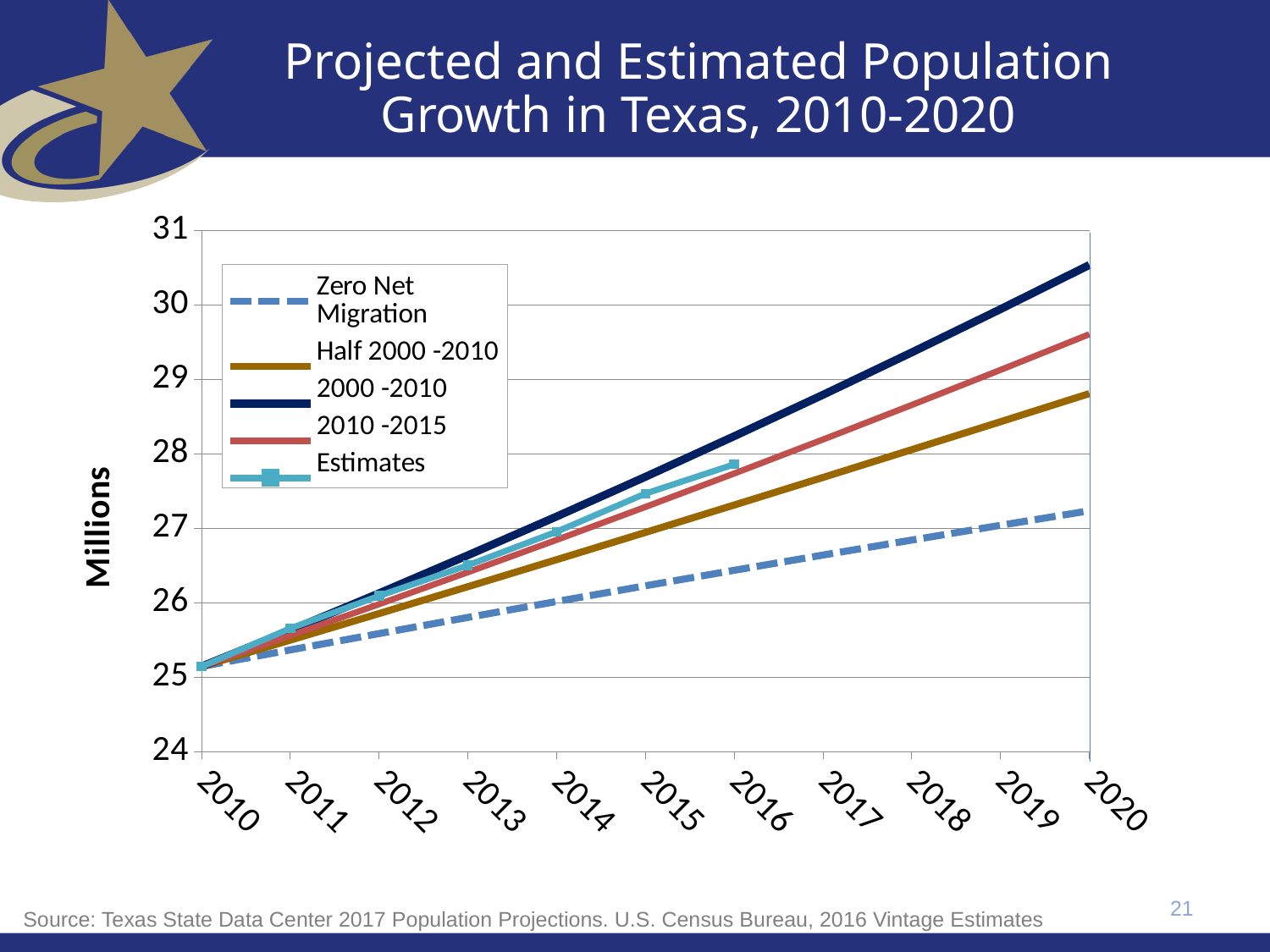
How many series does the legend list? 5 What is the label on the y axis? Millions How many years are labelled on the x axis? 11 Is the value for the 2000 -2010 series in 2020 greater or less than 30? greater What kind of chart is shown on the slide? line chart Is the value for the Estimates series in 2016 greater or less than 27? greater Which series has the highest value in 2020? 2000 -2010 Is the value for the Zero Net Migration series in 2020 greater or less than 28? less In 2020, which is larger: the 2010 -2015 series or the Half 2000 -2010 series? 2010 -2015 Which series has the lowest value in 2020? Zero Net Migration Do the values of the Zero Net Migration series rise or fall from 2010 to 2020? rise